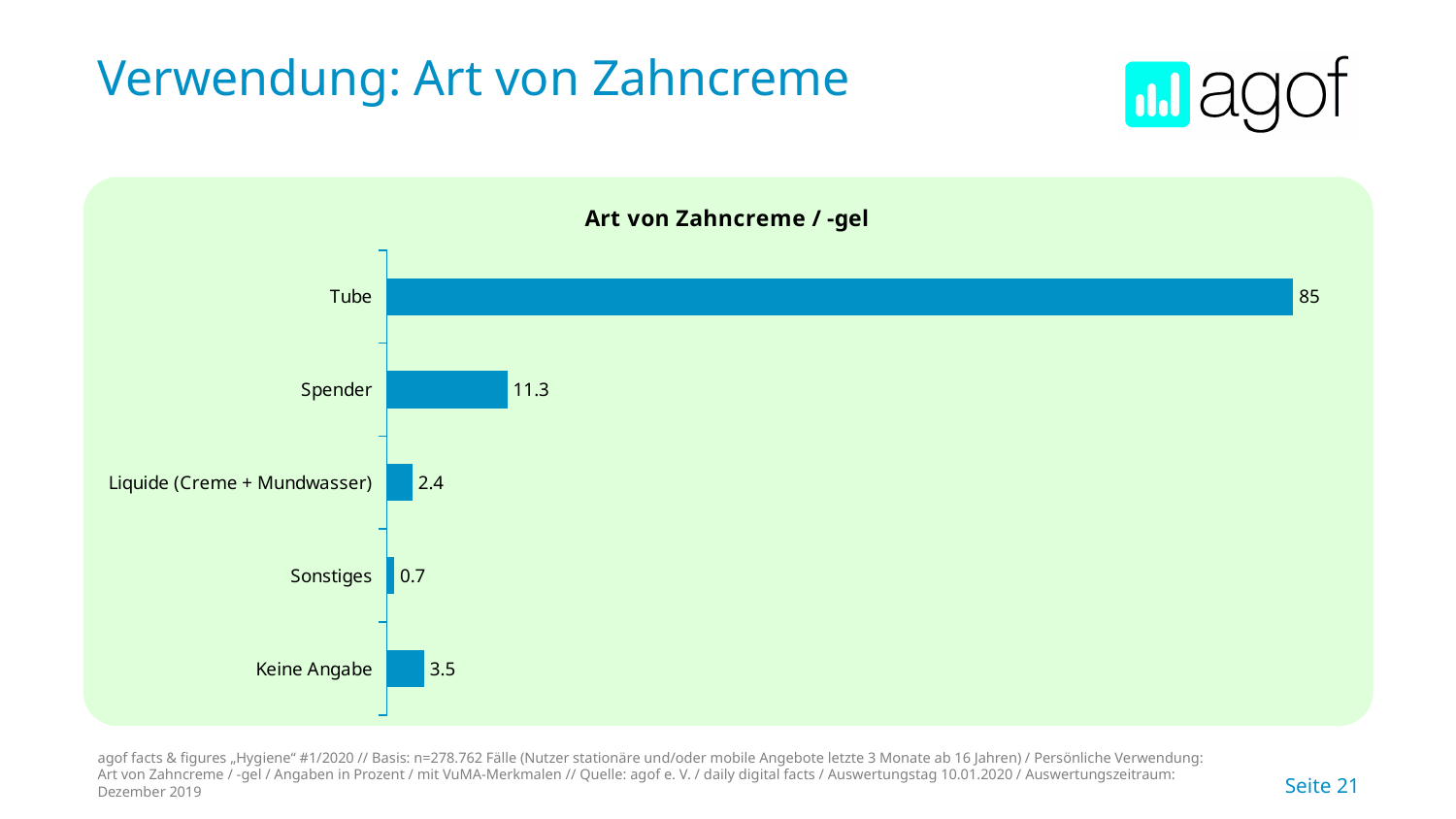
Which is larger, the value for Keine Angabe or the value for Liquide (Creme + Mundwasser)? Keine Angabe What is the value for Keine Angabe? 3.5 Which category has the highest value? Tube How many categories are shown in the chart? 5 What kind of chart is shown on the slide? Bar chart What is the value for Tube? 85 What is the difference between the values for Tube and Spender? 73.7 What is the value for Spender? 11.3 What is the title of the chart? Art von Zahncreme / -gel What is the value for Liquide (Creme + Mundwasser)? 2.4 Which category has the lowest value? Sonstiges What is the value for Sonstiges? 0.7